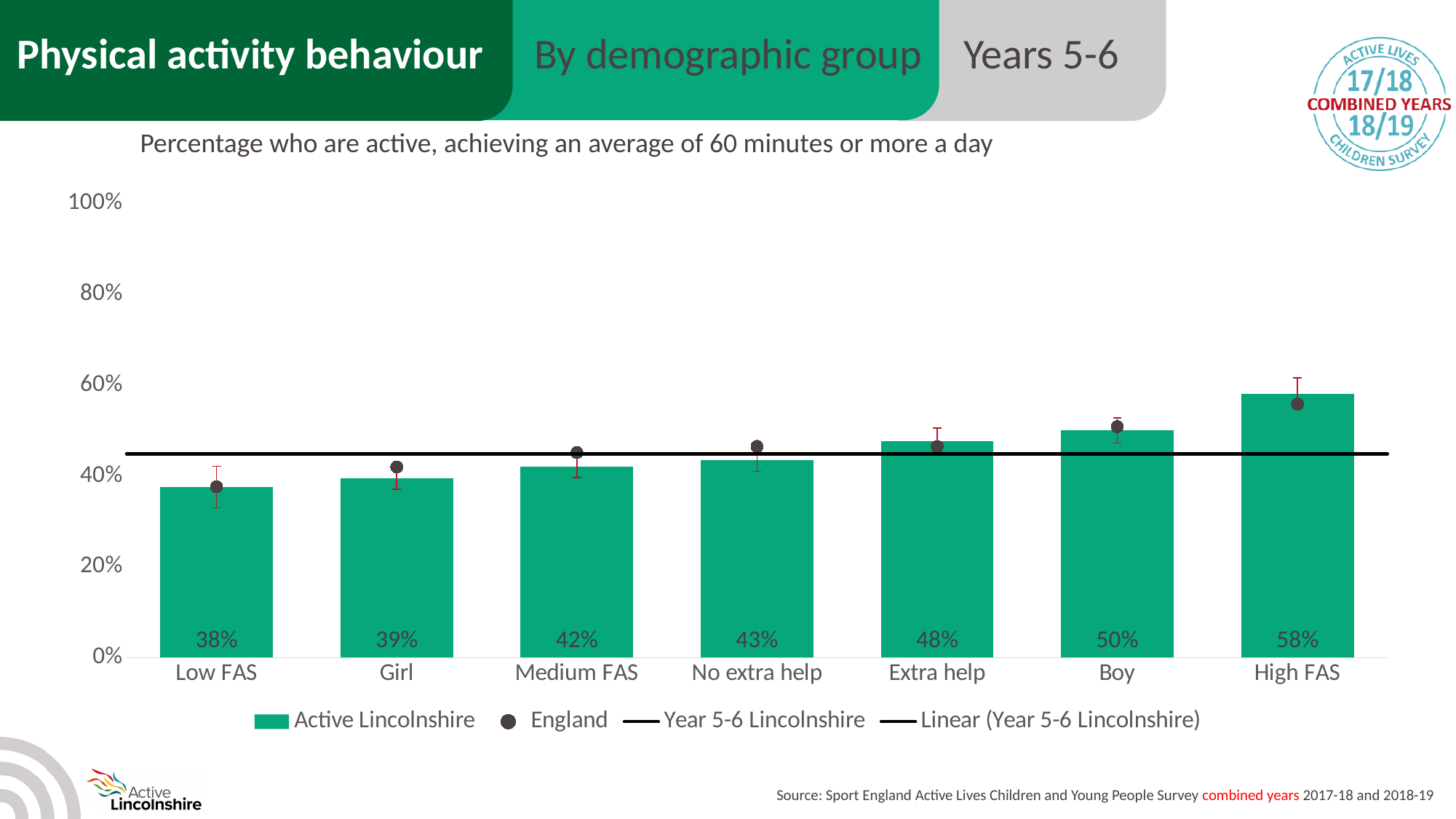
What is the Active Lincolnshire value for Low FAS? 38% Which category has the lowest Active Lincolnshire value? Low FAS Do the Active Lincolnshire values rise or fall from Low FAS to High FAS along the x axis? rise Which has a larger Active Lincolnshire value, Girl or Boy? Boy How many categories are shown on the x axis? 7 What is the Active Lincolnshire value for Boy? 50% What is the difference between the Active Lincolnshire values for High FAS and Low FAS? 20% Is the Active Lincolnshire value for Medium FAS greater or less than 60%? less Which category has the highest Active Lincolnshire value? High FAS How many series does the legend list? 4 What kind of chart is this? bar chart What is the Active Lincolnshire value for Extra help? 48%